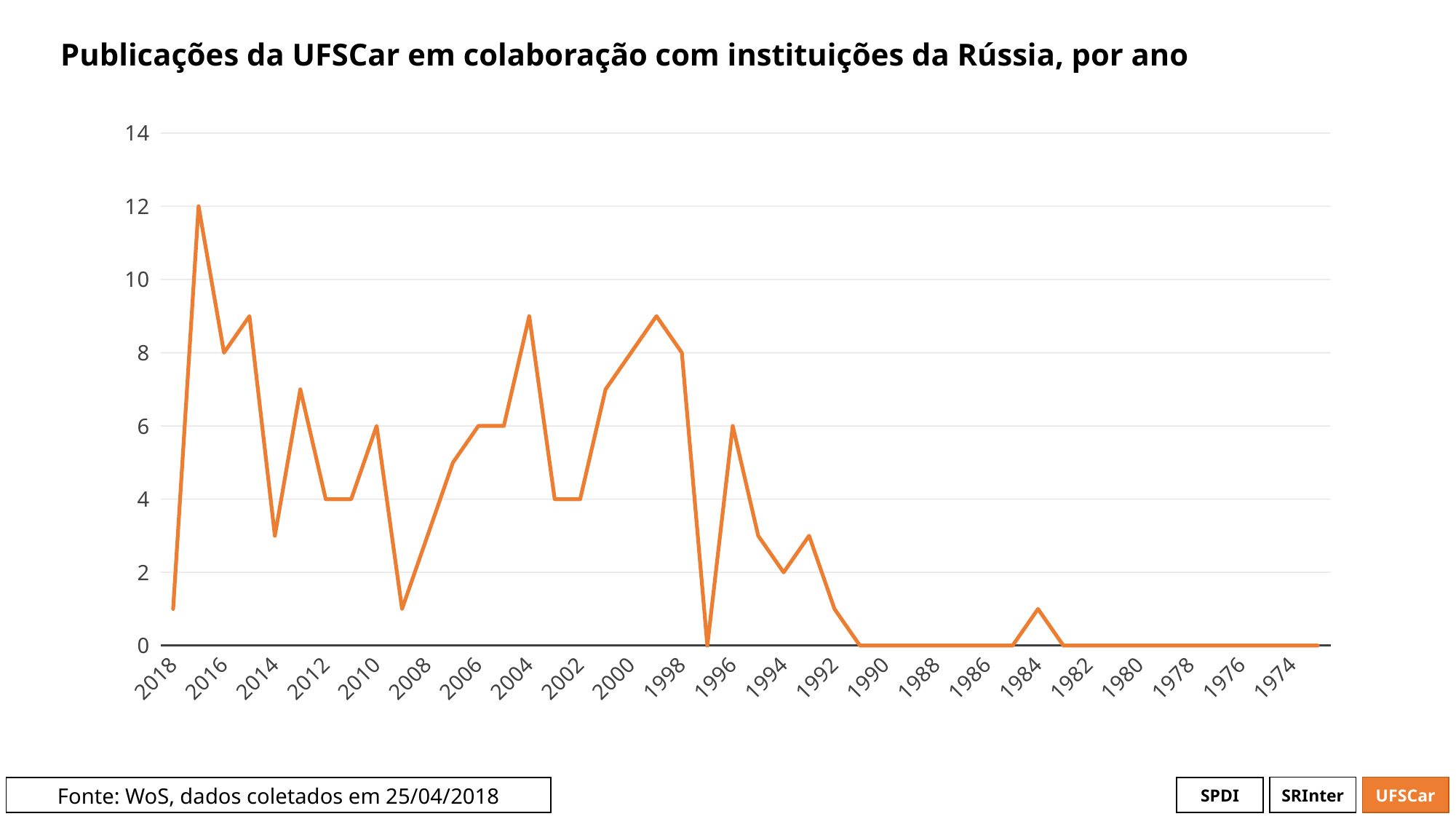
What is the value for 1998? 8 What is the value for 1988? 0 What is the value for 2012? 4 What is the title of the chart? Publicações da UFSCar em colaboração com instituições da Rússia, por ano Which year has the larger value, 2010 or 2012? 2010 What is the value for 2016? 8 Is the value for 2004 greater or less than 8? greater What is the highest value reached by the line? 12 What is the value for 2010? 6 What kind of chart is shown on the slide? line chart What is the difference between the values for 2016 and 1994? 6 What is the value for 1994? 2